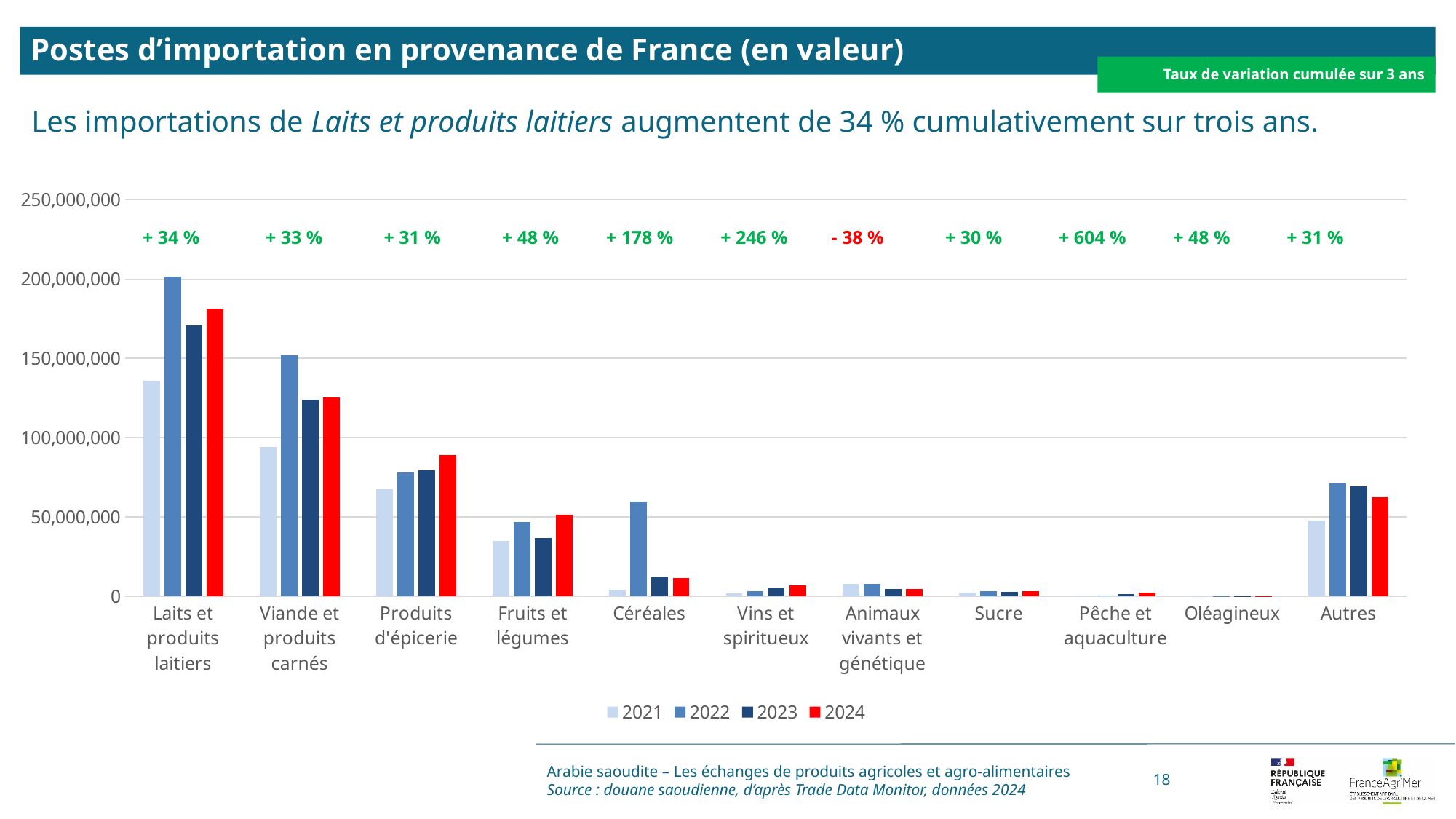
How many series does the legend list? 4 Which category shows a negative cumulative variation rate? Animaux vivants et génétique Which colour represents the 2024 series in the legend? red Is the 2022 value for Céréales greater or less than 50,000,000? greater How many product categories are shown on the x axis? 11 What kind of chart is shown on the slide? bar chart What is the cumulative three-year variation rate printed above Pêche et aquaculture? + 604 % What is the cumulative three-year variation rate printed above Laits et produits laitiers? + 34 % Is the 2021 value for Laits et produits laitiers greater or less than 150,000,000? less What is the cumulative three-year variation rate printed above Céréales? + 178 % Which category has the highest cumulative variation rate printed above it? Pêche et aquaculture For Laits et produits laitiers, which is larger: the 2022 value or the 2024 value? 2022